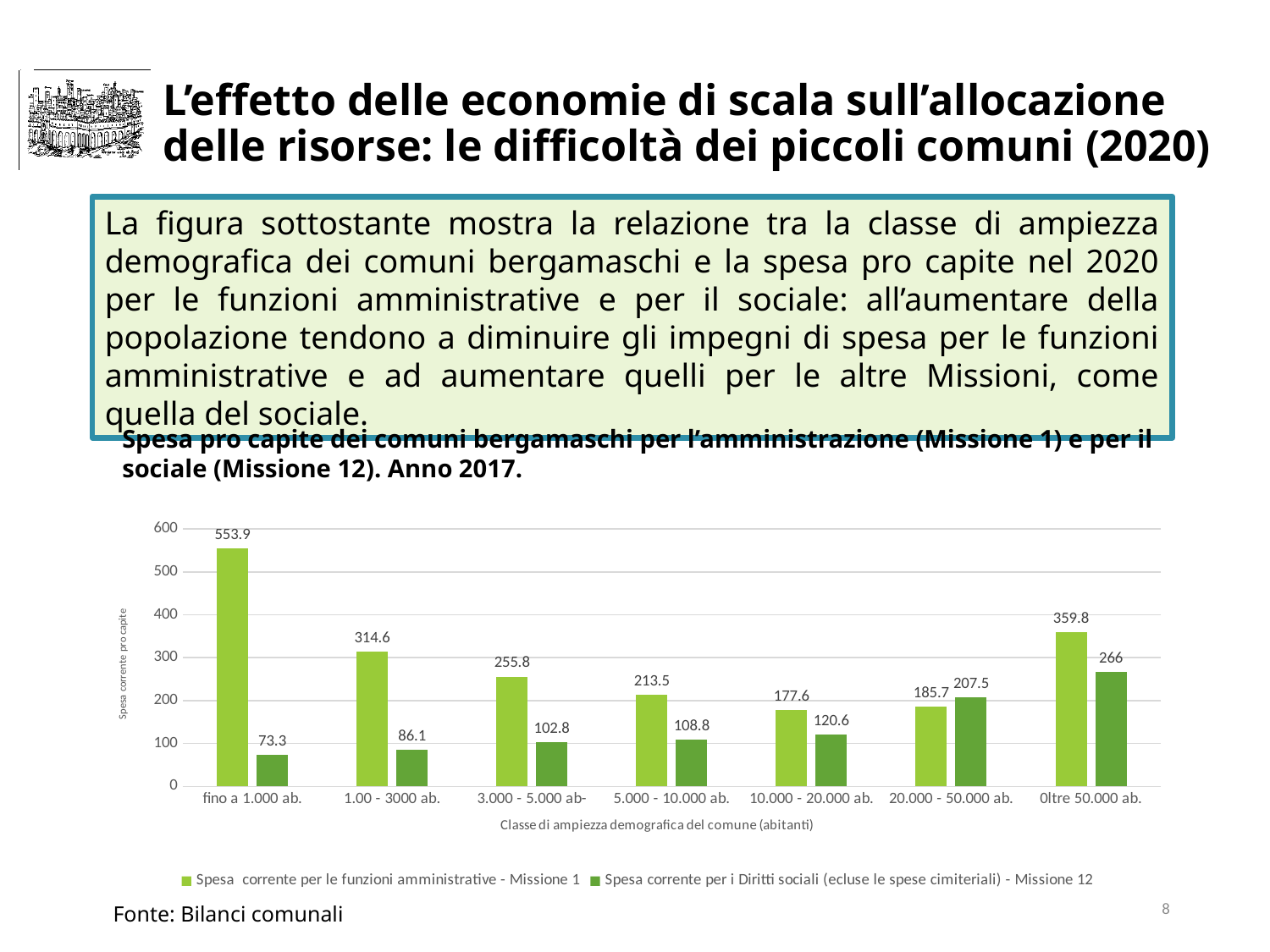
What is the value of Missione 12 spending for the class 'Oltre 50.000 ab.'? 266 How many series does the legend list? 2 What is the value of Missione 12 (Diritti sociali) spending for the class '20.000 - 50.000 ab.'? 207.5 What is the difference between Missione 1 and Missione 12 spending for the class 'fino a 1.000 ab.'? 480.6 What is the value of Missione 1 (funzioni amministrative) spending for the class 'fino a 1.000 ab.'? 553.9 What type of chart is shown on the slide? bar chart How many population classes (categories) are shown on the x axis? 7 Which population class has the lowest Missione 1 (funzioni amministrative) spending? 10.000 - 20.000 ab. Which population class has the lowest Missione 12 (Diritti sociali) spending? fino a 1.000 ab. Which population class has the highest Missione 1 (funzioni amministrative) spending? fino a 1.000 ab. Does Missione 12 (Diritti sociali) spending rise or fall as the population class increases along the x axis? rise For the class '20.000 - 50.000 ab.', which is larger: Missione 1 spending or Missione 12 spending? Missione 12 spending